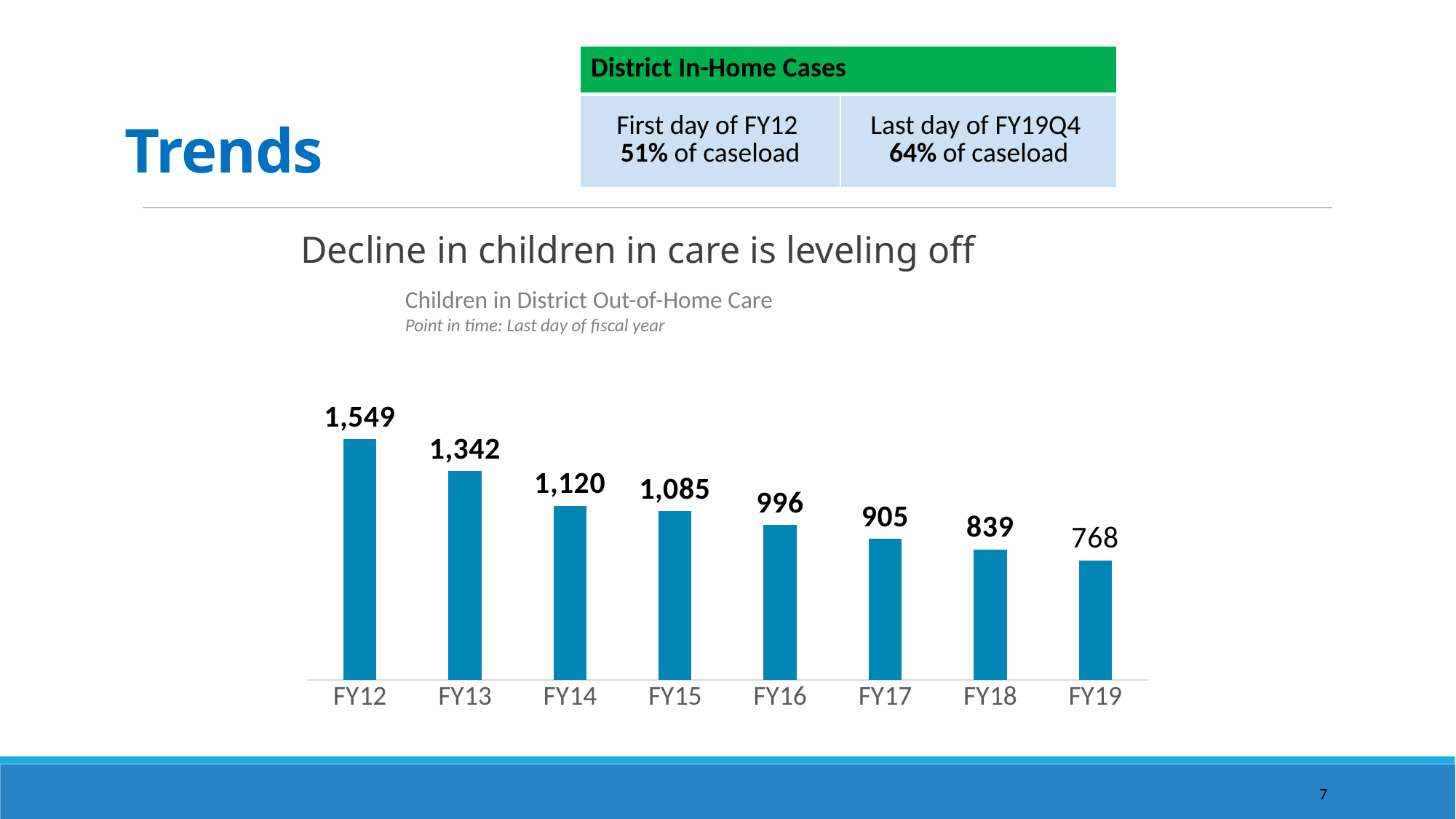
What is the value for FY12 in the Children in District Out-of-Home Care chart? 1,549 Which is larger in the Children in District Out-of-Home Care chart, the value for FY14 or FY15? FY14 What is the title of the chart on the slide? Children in District Out-of-Home Care Which fiscal year has the lowest number of children in District Out-of-Home Care? FY19 Do the values in the Children in District Out-of-Home Care chart rise or fall from FY12 to FY19? Fall How many fiscal years are shown in the Children in District Out-of-Home Care chart? 8 What is the value for FY19 in the Children in District Out-of-Home Care chart? 768 What is the difference between the FY12 and FY13 values in the Children in District Out-of-Home Care chart? 207 What kind of chart is used to show Children in District Out-of-Home Care? Bar chart Which fiscal year has the highest number of children in District Out-of-Home Care? FY12 What is the difference between the FY18 and FY19 values in the Children in District Out-of-Home Care chart? 71 What is the value for FY16 in the Children in District Out-of-Home Care chart? 996